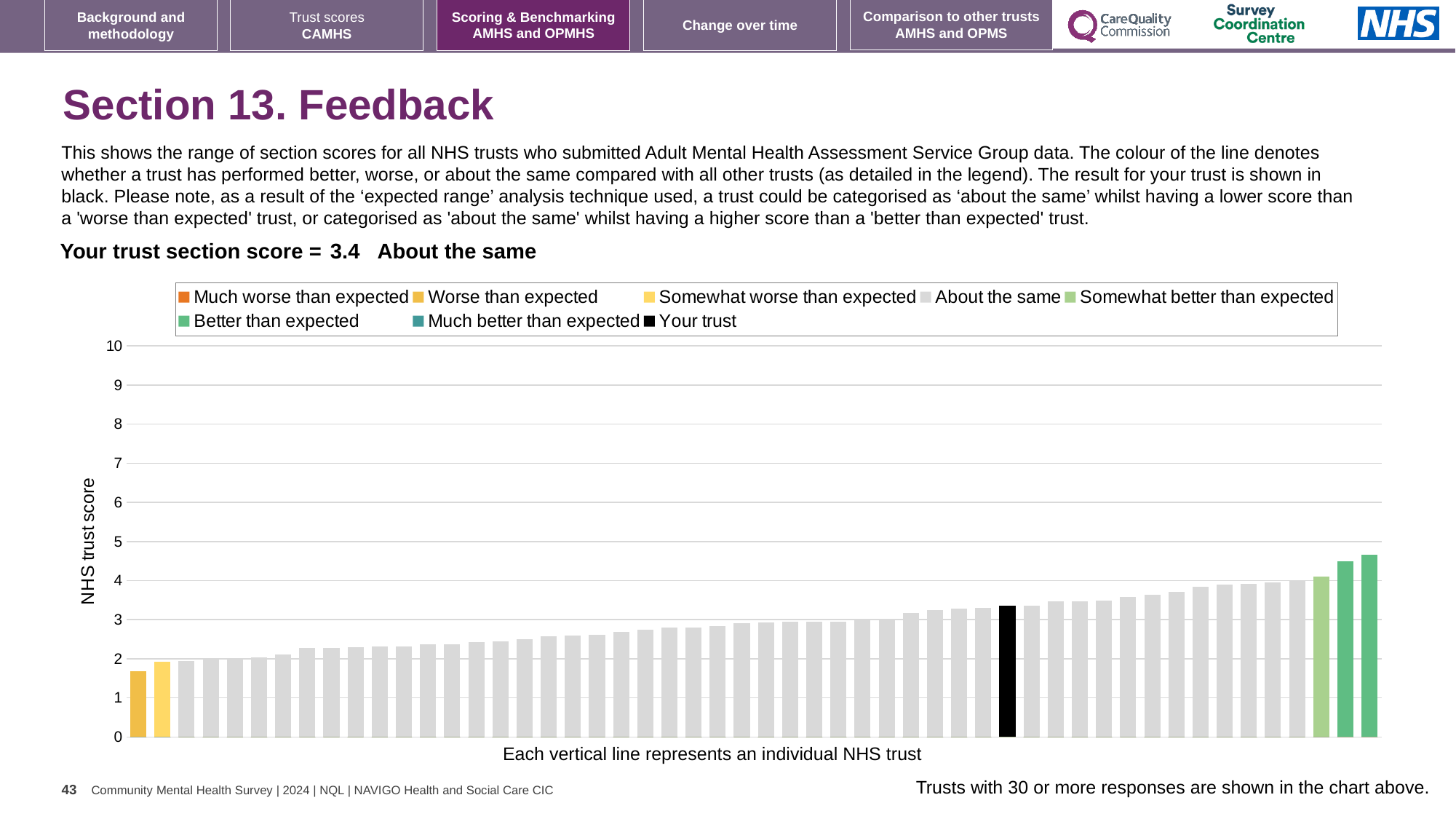
What is the label on the y axis of the chart? NHS trust score Do the bar values rise or fall from left to right along the x axis? rise What is the section score for your trust shown on the slide? 3.4 How many bars are coloured as 'Worse than expected' (dark yellow)? 1 How many bars are coloured as 'Better than expected' (dark green)? 2 Is the value of the shortest bar in the chart greater or less than 2? less Which category does your trust's section score fall into? About the same Is the value of the tallest bar in the chart greater or less than 4? greater What kind of chart is shown on the slide? bar chart Is the value of the black 'Your trust' bar greater or less than 3? greater What colour is the bar representing your trust? black How many entries does the chart legend list? 8